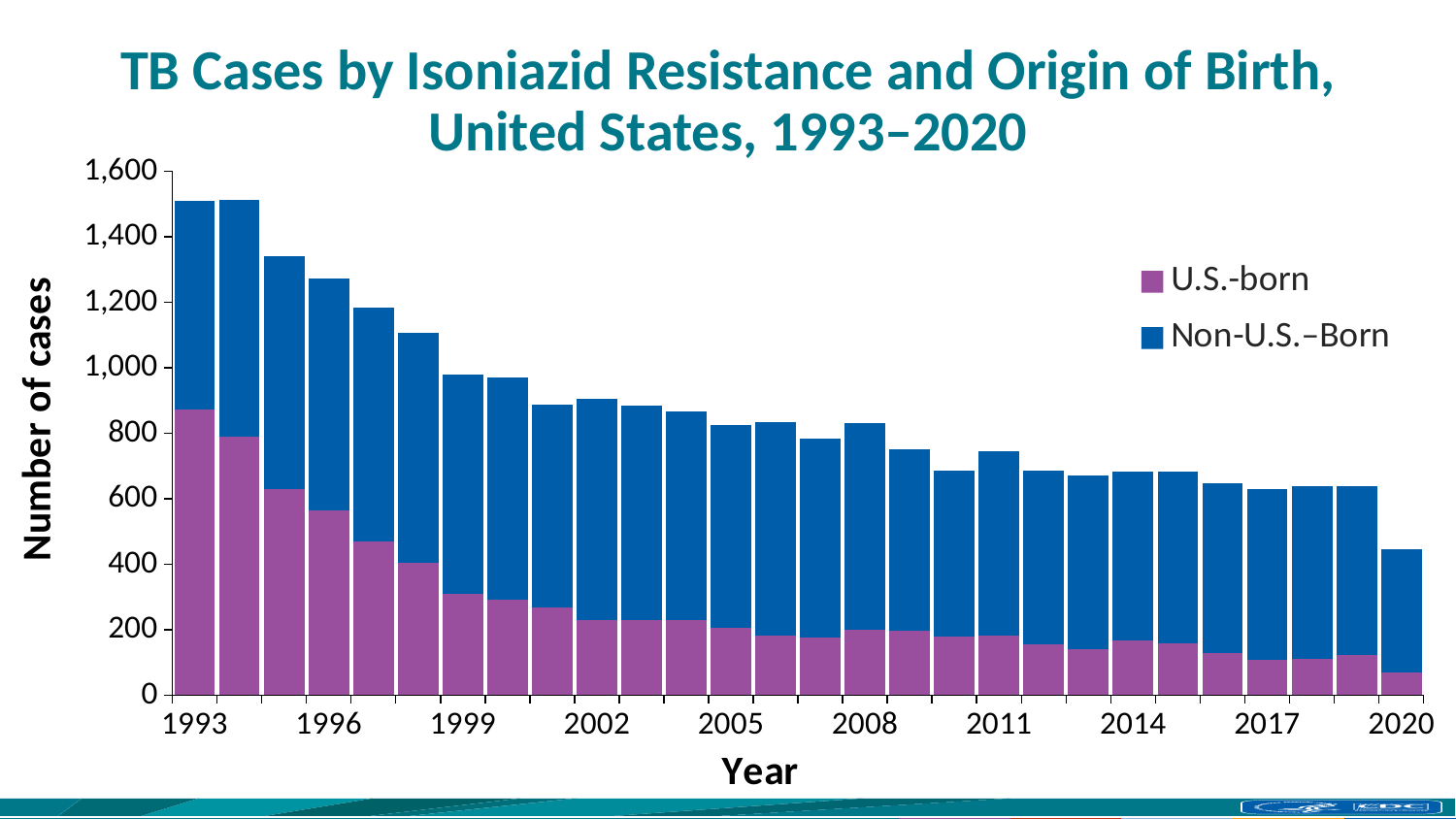
Do the total TB cases generally rise or fall from 1993 to 2020? Fall Which year has more U.S.-born cases, 1993 or 2020? 1993 Which year has the lowest total number of TB cases? 2020 Is the number of U.S.-born cases in 1993 greater or less than 800? greater How many series does the legend list? 2 What is the title of the chart? TB Cases by Isoniazid Resistance and Origin of Birth, United States, 1993–2020 Is the number of U.S.-born cases in 2020 greater or less than 200? less Is the total number of cases in 1993 greater or less than 1,400? greater What kind of chart is shown on the slide? Stacked bar chart How many years (bars) are plotted on the x axis? 28 Which series is shown in purple? U.S.-born